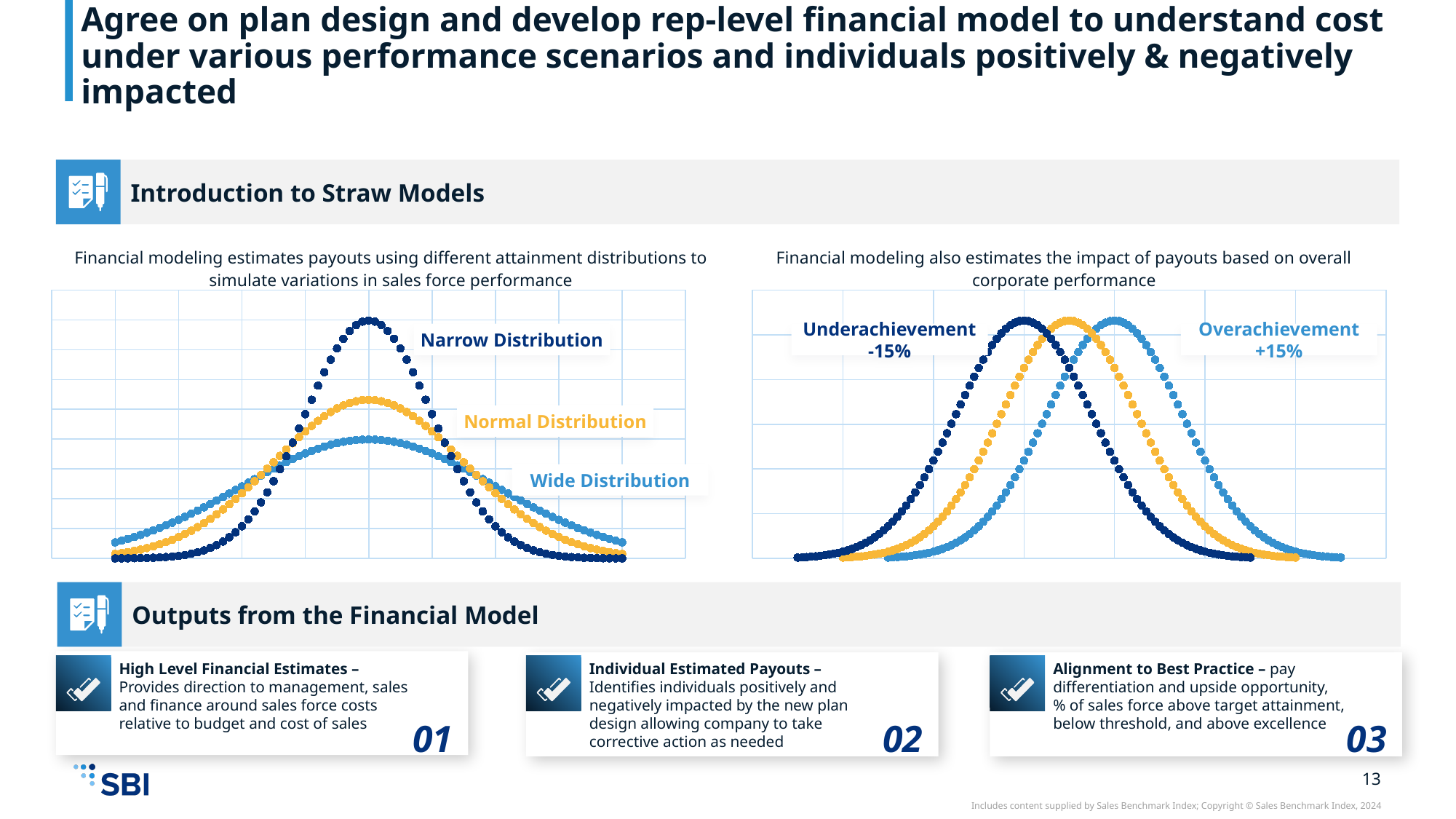
In the right chart, which labelled scenario's curve peaks furthest to the left? Underachievement -15% In the left chart, what colour is the Normal Distribution curve? Yellow How many curves are plotted in the right chart on corporate performance? 3 In the right chart, what percentage shift is labelled for the Overachievement scenario? +15% How many distribution curves are plotted in the left chart? 3 In the left chart, which distribution has the lowest peak? Wide Distribution What kind of chart is the left chart showing the attainment distributions? Line chart In the right chart, which labelled scenario's curve peaks furthest to the right? Overachievement +15% In the right chart, what percentage shift is labelled for the Underachievement scenario? -15% In the left chart, which curve peaks higher, the Normal Distribution or the Wide Distribution? Normal Distribution In the left chart, which distribution has the highest peak? Narrow Distribution In the right chart, what colour is the Overachievement +15% curve? Light blue